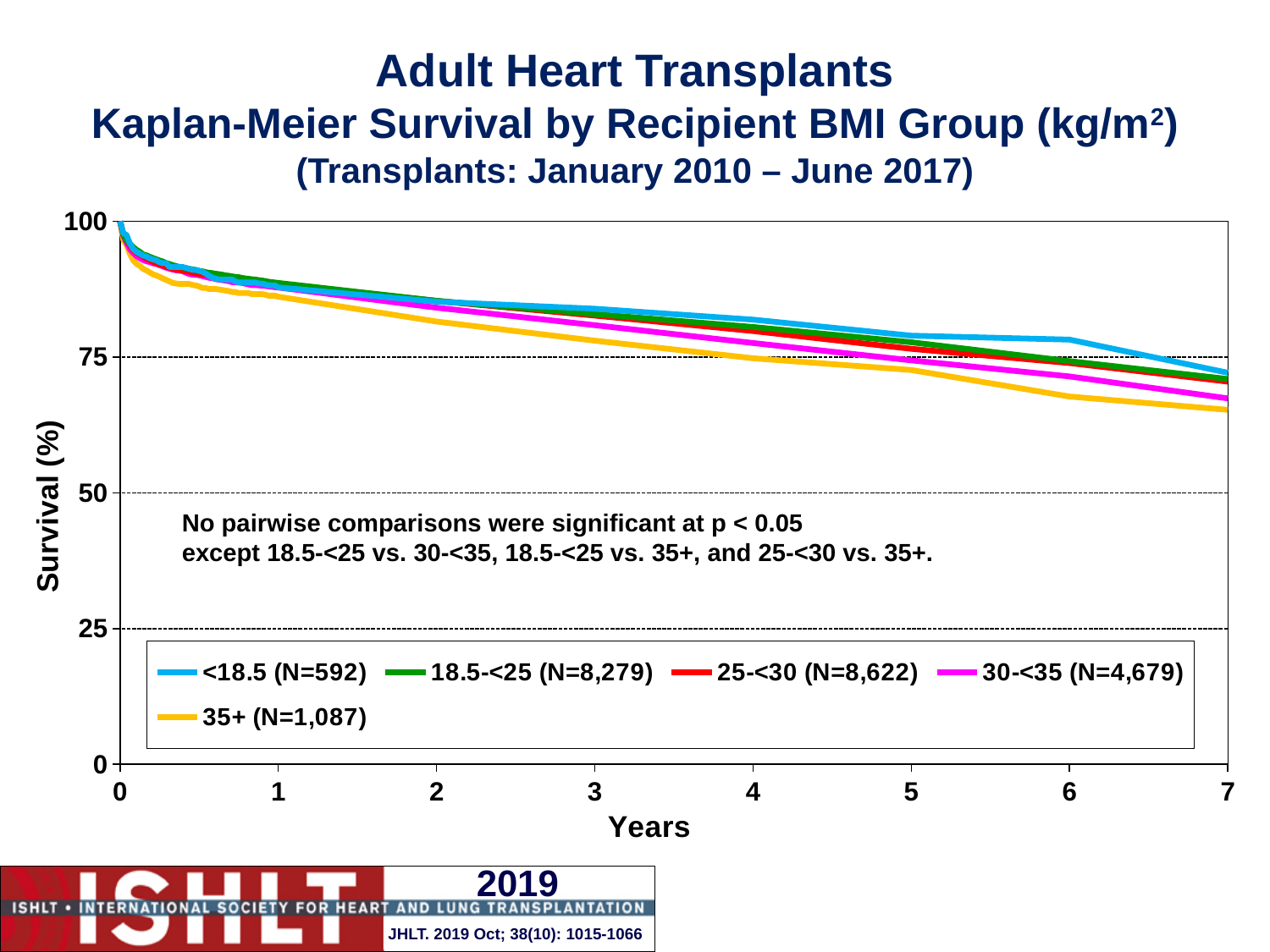
At year 7, which group has higher survival: <18.5 or 35+? <18.5 What kind of chart is shown on the slide? Line chart What transplant date range is given in the chart title? January 2010 – June 2017 Which BMI group has the highest survival at year 6? <18.5 Which BMI group has the lowest survival at year 7? 35+ Is the survival value for the 35+ group at year 7 greater or less than 75? less Is the survival value for the <18.5 group at year 1 greater or less than 75? greater What is the N for the 25-<30 BMI group shown in the legend? N=8,622 Is the survival value for the 30-<35 group at year 3 greater or less than 75? greater How many BMI groups does the legend list? 5 Do the survival curves rise or fall as years increase? Fall